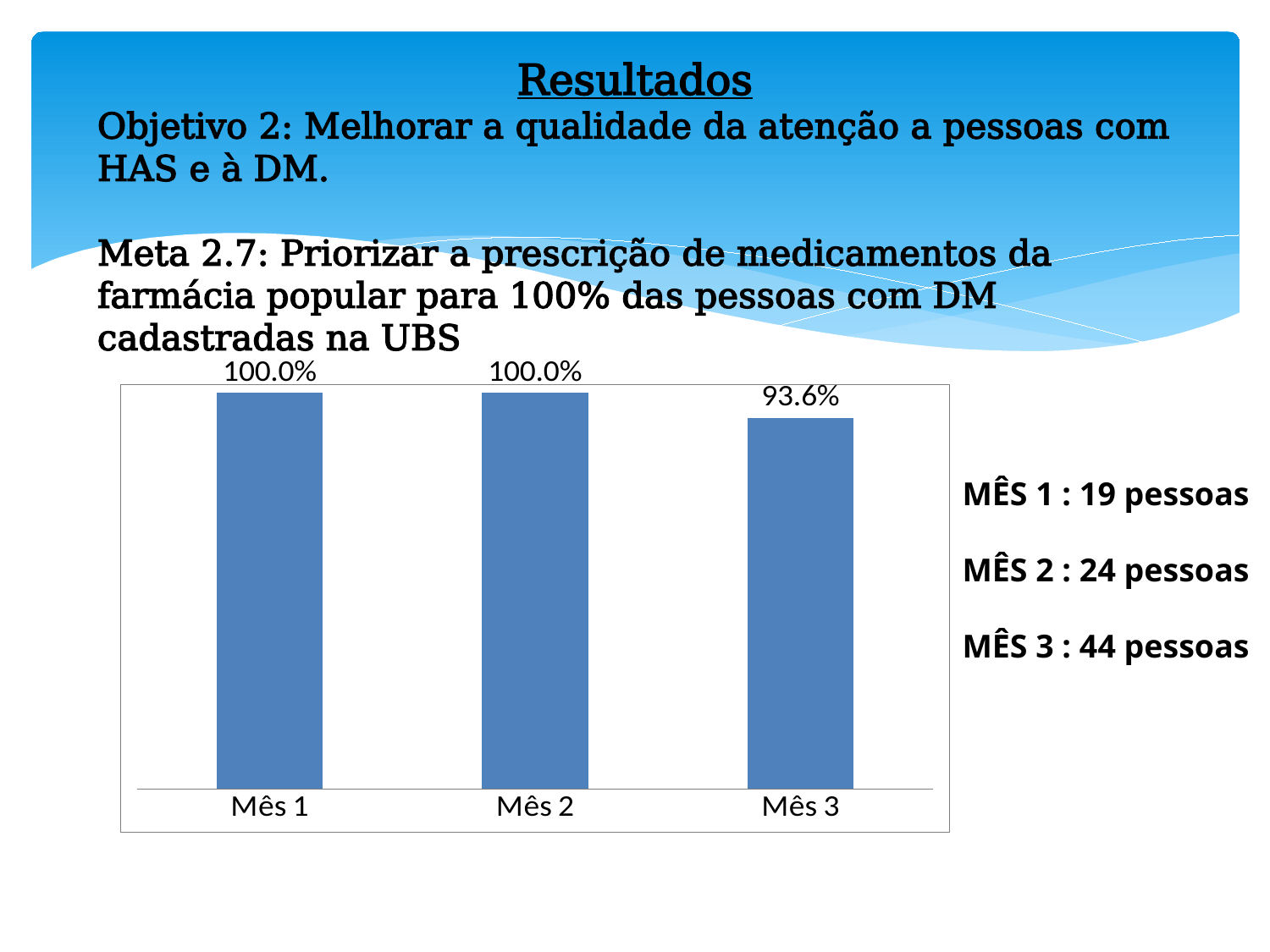
What is the value for Mês 3? 93.6% Do the values rise or fall from Mês 2 to Mês 3? Fall Which month has the lowest value? Mês 3 Which is larger, the value for Mês 2 or the value for Mês 3? Mês 2 What is the value for Mês 2? 100.0% What colour are the bars in the chart? Blue According to the text beside the chart, how many people does Mês 3 correspond to? 44 pessoas What is the difference between the values for Mês 1 and Mês 3? 6.4% What kind of chart is shown on the slide? Bar chart What is the value for Mês 1? 100.0% Do the values for Mês 1 and Mês 2 differ? No, both are 100.0% How many categories are shown on the x axis of the chart? 3